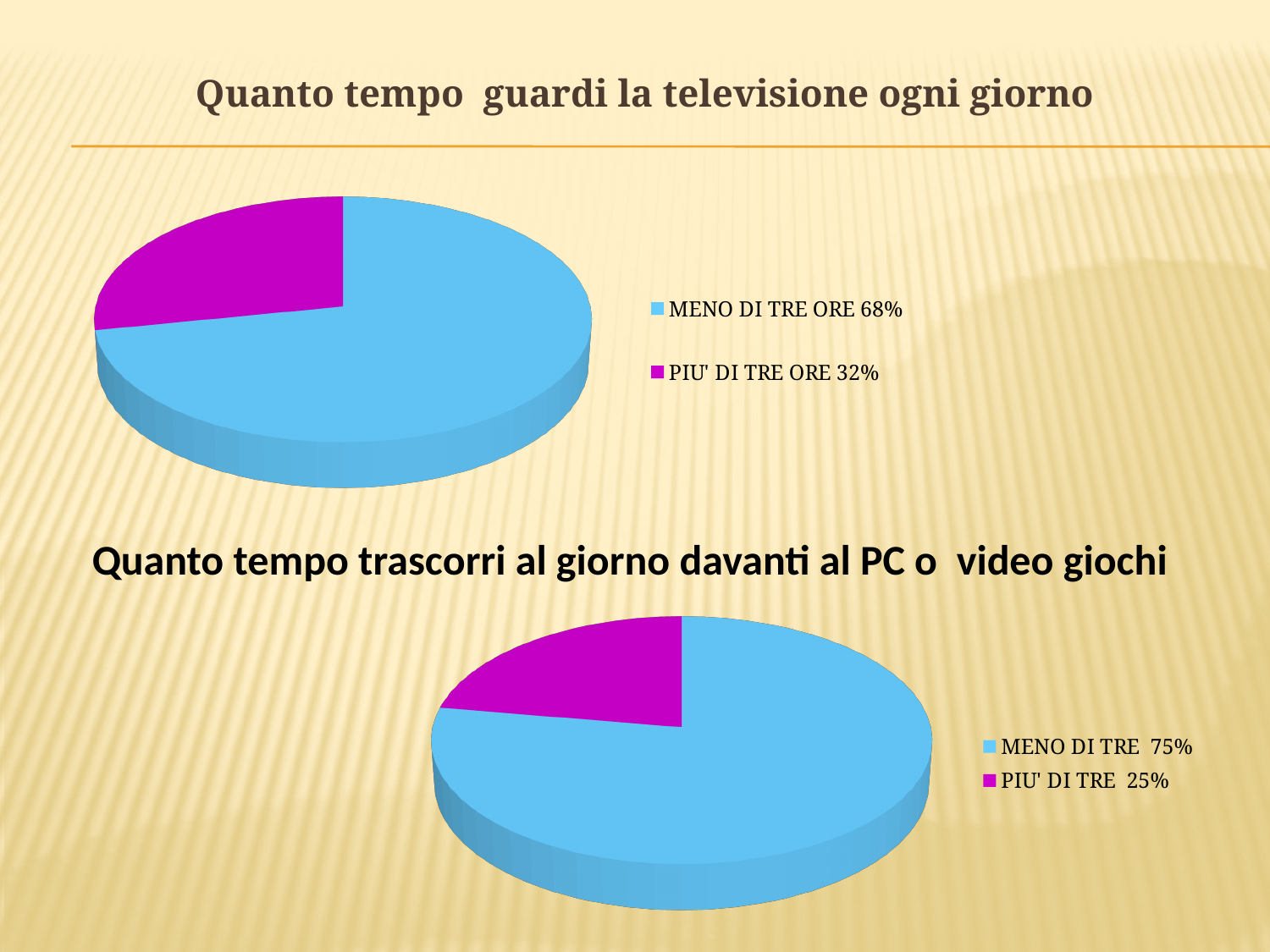
In the bottom chart (PC o video giochi), which category has the smallest slice? PIU' DI TRE In the bottom chart (PC o video giochi), what is the difference between the MENO DI TRE and PIU' DI TRE shares? 50% What kind of chart is the top chart (television)? Pie chart In the top chart (television), what share is shown for MENO DI TRE ORE? 68% How many categories does the bottom chart (PC o video giochi) show? 2 In the top chart (television), what is the difference between the MENO DI TRE ORE and PIU' DI TRE ORE shares? 36% Which is larger: the PIU' DI TRE ORE share in the top chart or the PIU' DI TRE share in the bottom chart? PIU' DI TRE ORE in the top chart In the bottom chart (PC o video giochi), what share is shown for MENO DI TRE? 75% In the top chart (television), which category has the largest slice? MENO DI TRE ORE In the top chart (television), what colour is the PIU' DI TRE ORE slice? Magenta In the top chart (television), what share is shown for PIU' DI TRE ORE? 32% In the bottom chart (PC o video giochi), what share is shown for PIU' DI TRE? 25%